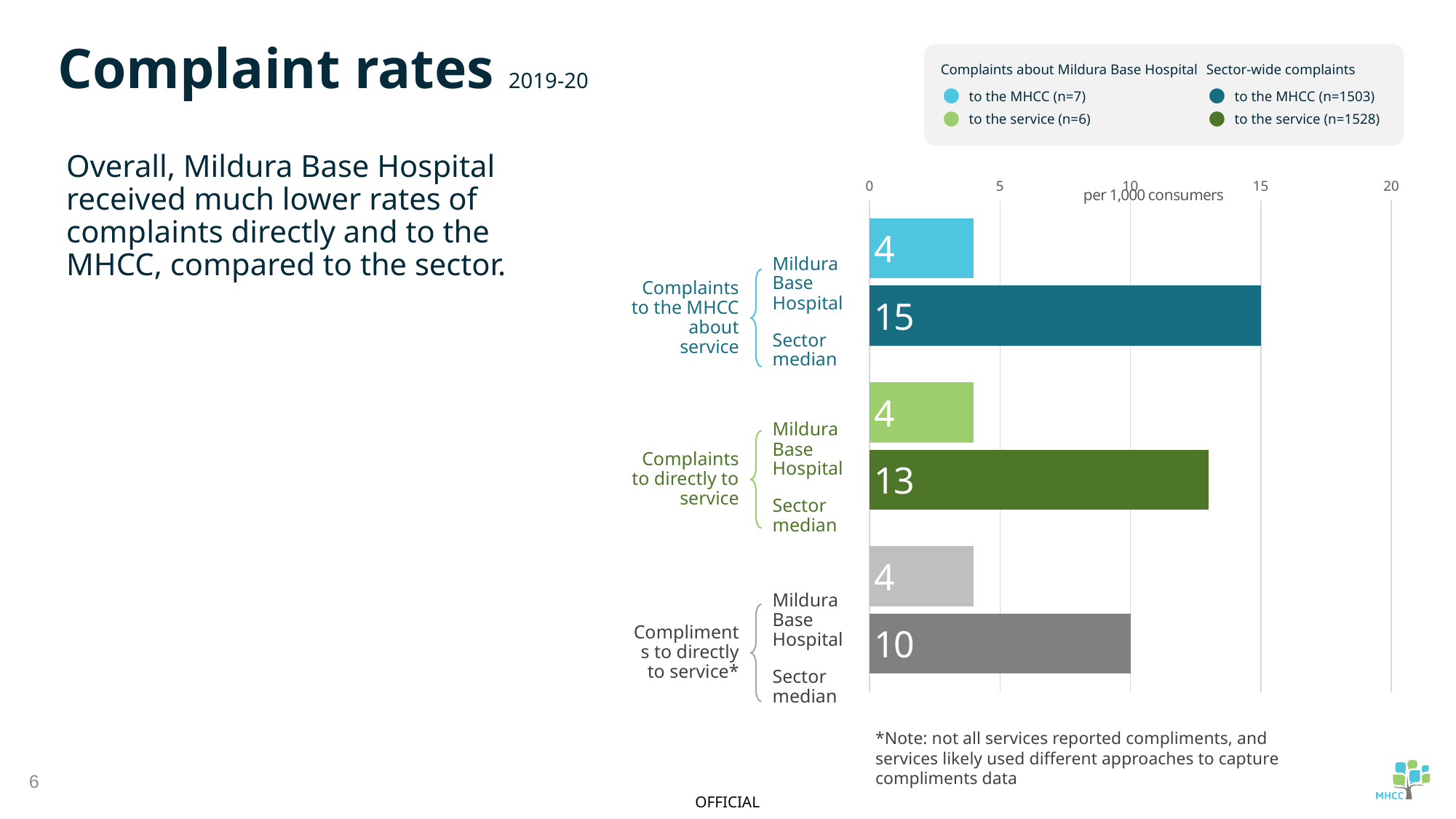
Which bar has the highest value on the chart? Sector median, complaints to the MHCC about service What is the difference between the sector median and Mildura Base Hospital for complaints to the MHCC about service? 11 What is the sector median for complaints directly to service? 13 What is the sector median for compliments directly to service? 10 What unit does the x axis of the chart use? per 1,000 consumers How many bars are plotted on the chart? 6 What is the value for Mildura Base Hospital for complaints to the MHCC about service? 4 What is the sector median for complaints to the MHCC about service? 15 What is the difference between the sector median and Mildura Base Hospital for complaints directly to service? 9 Is the sector median for complaints directly to service greater or less than 10? greater Which is larger for compliments directly to service: Mildura Base Hospital or the sector median? Sector median What kind of chart is shown on the slide? Bar chart